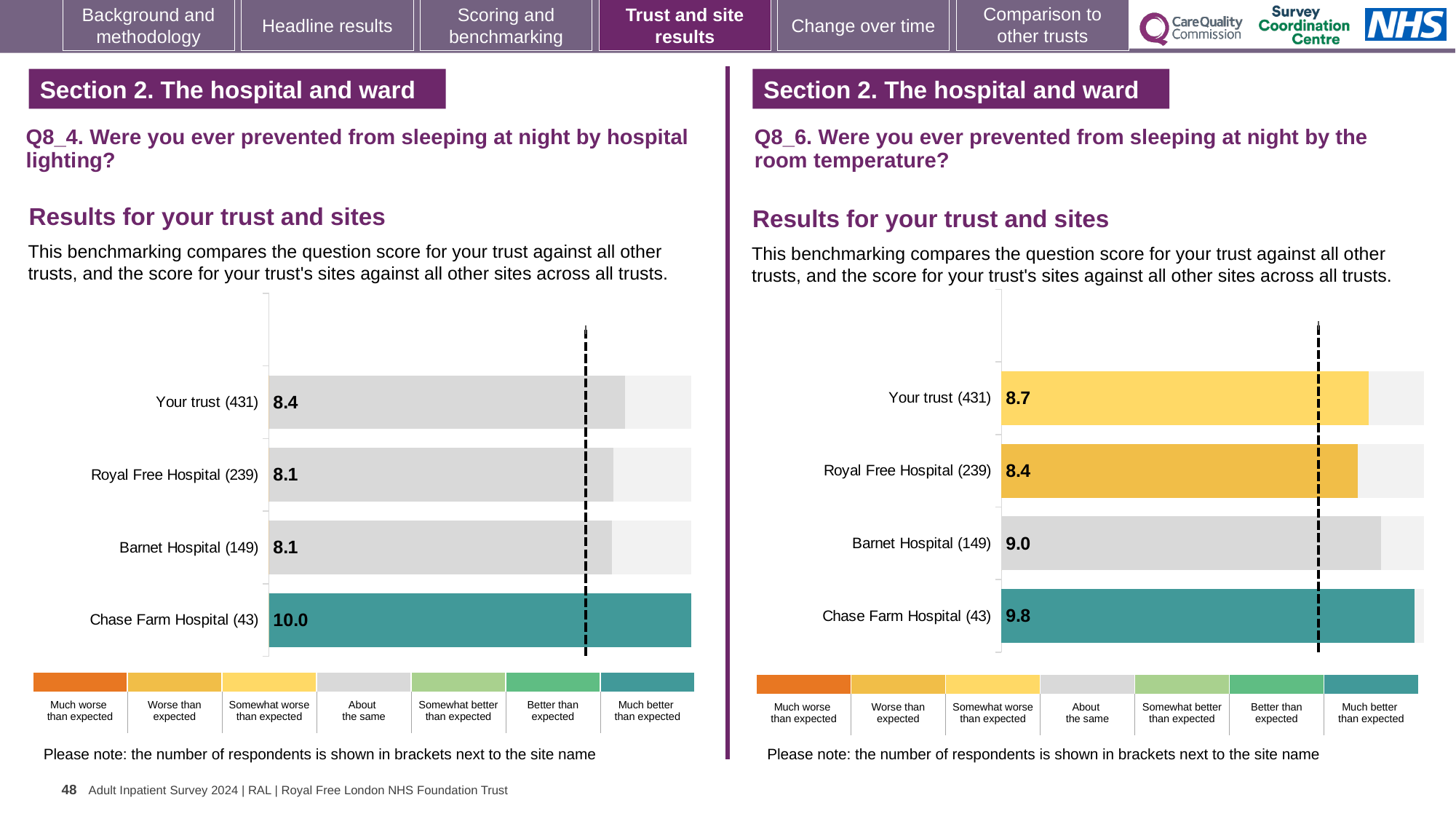
In the Q8_4 chart (hospital lighting), how many bars are plotted? 4 In the Q8_6 chart (room temperature), which is larger: the score for Your trust (431) or Barnet Hospital (149)? Barnet Hospital (149) In the Q8_6 chart (room temperature), what is the score for Royal Free Hospital (239)? 8.4 In the Q8_6 chart (room temperature), which benchmark category does the colour of the Chase Farm Hospital (43) bar correspond to? Much better than expected In the Q8_6 chart (room temperature), which site has the lowest score? Royal Free Hospital (239) In the Q8_4 chart (hospital lighting), which site has the highest score? Chase Farm Hospital (43) In the Q8_4 chart (hospital lighting), what is the difference between the scores for Chase Farm Hospital (43) and Royal Free Hospital (239)? 1.9 In the Q8_6 chart (room temperature), what is the score for Barnet Hospital (149)? 9.0 What kind of chart is used for the Q8_6 (room temperature) results? Bar chart In the Q8_6 chart (room temperature), what is the difference between the scores for Chase Farm Hospital (43) and Your trust (431)? 1.1 In the Q8_4 chart (hospital lighting), what is the score for Chase Farm Hospital (43)? 10.0 In the Q8_4 chart (hospital lighting), what is the score for Your trust (431)? 8.4